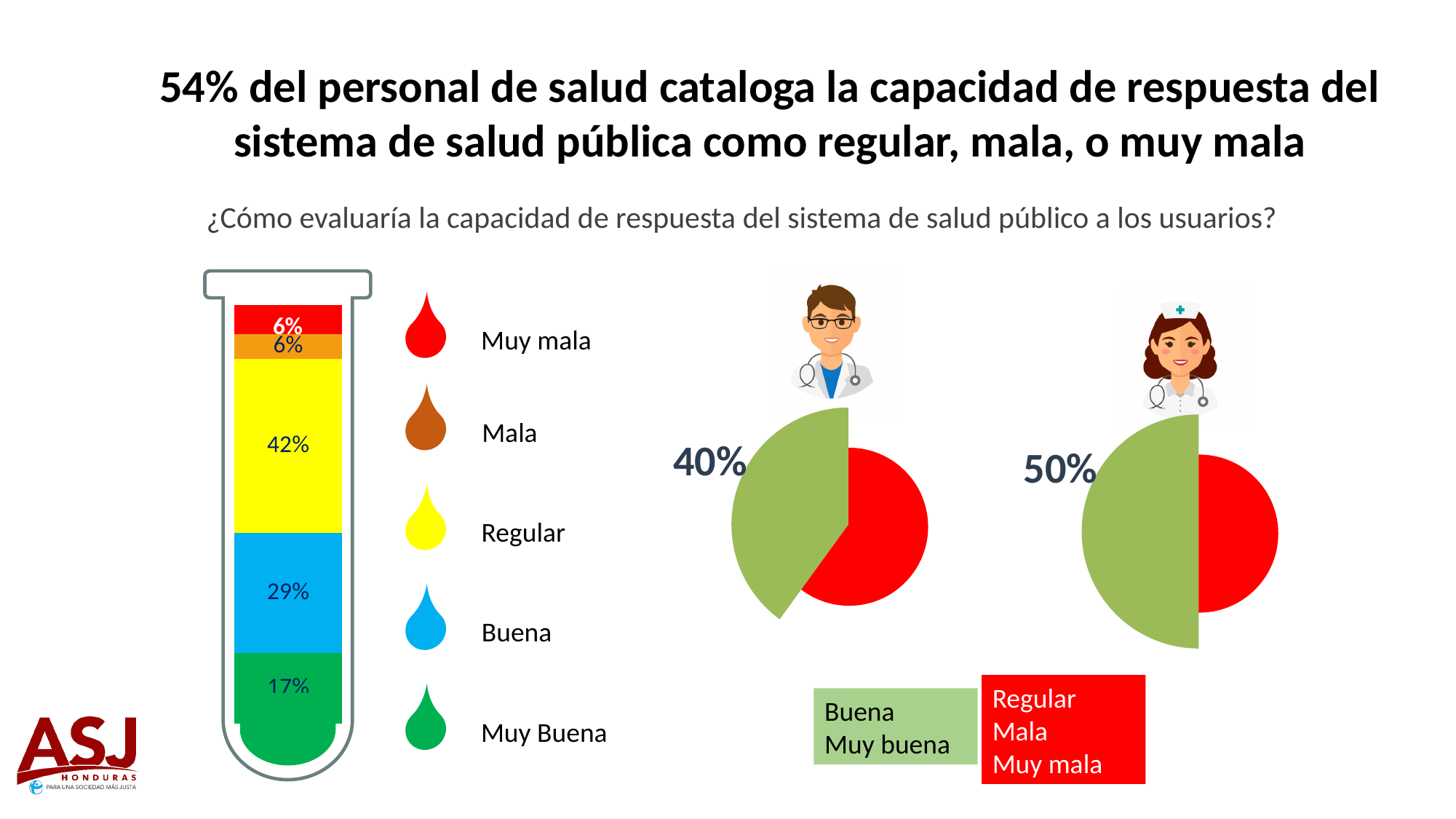
In the test-tube stacked bar chart on the left, how many rating categories are shown? 5 In the test-tube stacked bar chart on the left, which category has the largest share? Regular In the test-tube stacked bar chart on the left, what percentage rated the response capacity as Muy mala? 6% In the test-tube stacked bar chart on the left, what percentage of health personnel rated the response capacity as Regular? 42% In the test-tube stacked bar chart on the left, which is larger, Buena or Muy Buena? Buena In the test-tube stacked bar chart on the left, what is the combined percentage of Muy mala and Mala? 12% In the pie chart under the doctor figure, what percentage is labelled for the green (Buena / Muy buena) slice? 40% In the test-tube stacked bar chart on the left, what percentage rated the response capacity as Muy Buena? 17% In the test-tube stacked bar chart on the left, what percentage rated the response capacity as Buena? 29% In the pie chart under the nurse figure, what percentage is labelled for the green (Buena / Muy buena) slice? 50% In the test-tube stacked bar chart on the left, what is the difference between the Regular and Buena percentages? 13% In the test-tube stacked bar chart on the left, what colour represents the Regular category? Yellow